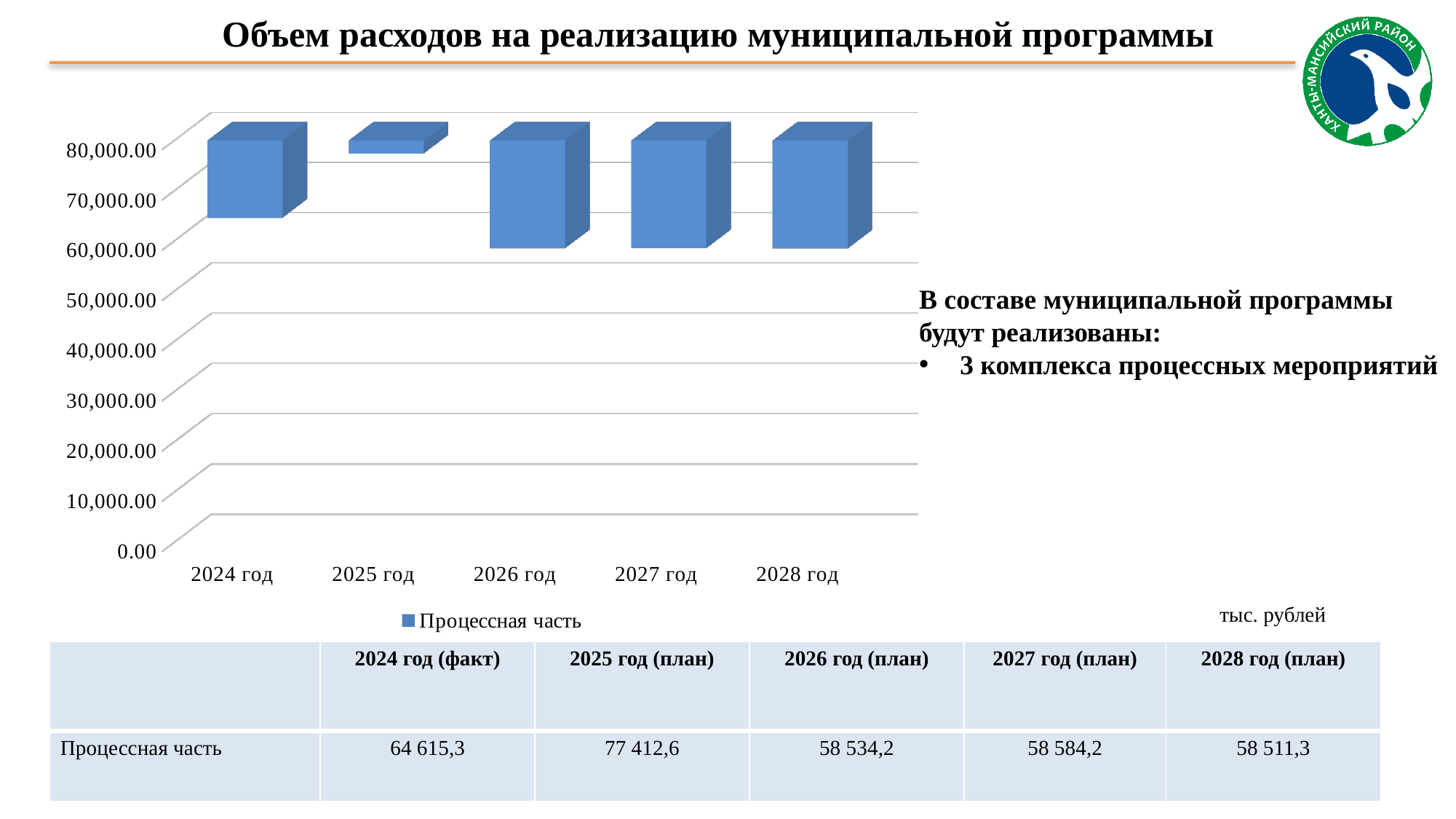
How many years (categories) are shown on the x axis of the chart? 5 What is the name of the series shown in the chart legend? Процессная часть Which year has the highest value of Процессная часть? 2025 год What is the title of the chart? Объем расходов на реализацию муниципальной программы What kind of chart is shown on the slide? bar chart What is the difference between the 2025 год (план) and 2024 год (факт) values of Процессная часть? 12 797,3 Is the value for 2025 год greater or less than 70,000.00? greater What is the value of Процессная часть for 2024 год (факт)? 64 615,3 What is the value of Процессная часть for 2025 год (план)? 77 412,6 How many series does the chart legend list? 1 What is the value of Процессная часть for 2028 год (план)? 58 511,3 Which is larger, the value for 2024 год or the value for 2026 год? 2024 год